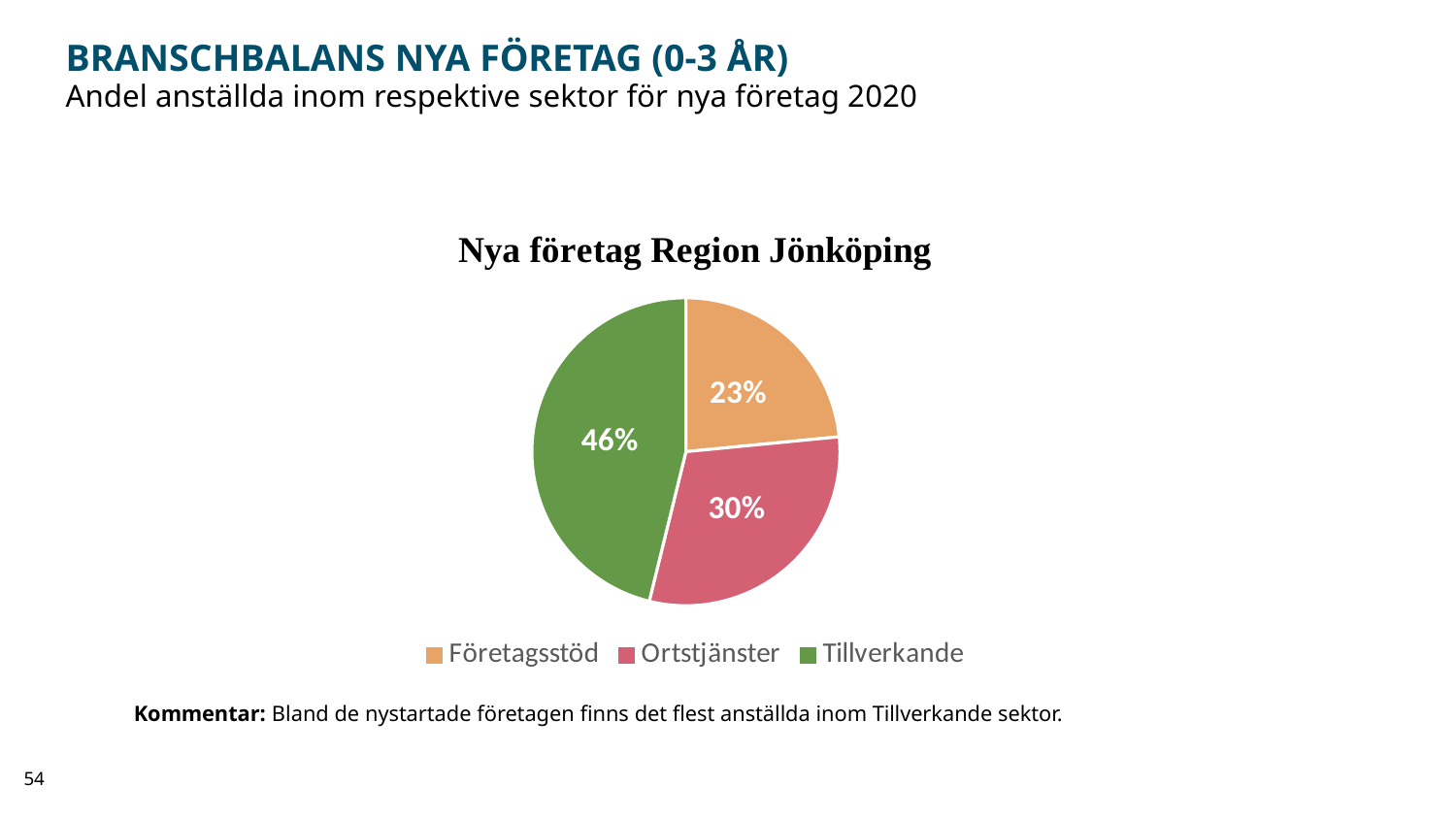
Which is larger, the share for Ortstjänster or the share for Företagsstöd? Ortstjänster What share of the pie does Ortstjänster have? 30% How many entries does the legend list? 3 What is the difference in percentage points between Tillverkande and Ortstjänster? 16 What share of the pie does Företagsstöd have? 23% What share of the pie does Tillverkande have? 46% What kind of chart is shown on the slide? pie chart How many slices does the pie chart have? 3 What is the title of the chart? Nya företag Region Jönköping Which sector has the largest share of the pie? Tillverkande Which sector has the smallest share of the pie? Företagsstöd What colour is the Tillverkande slice? green